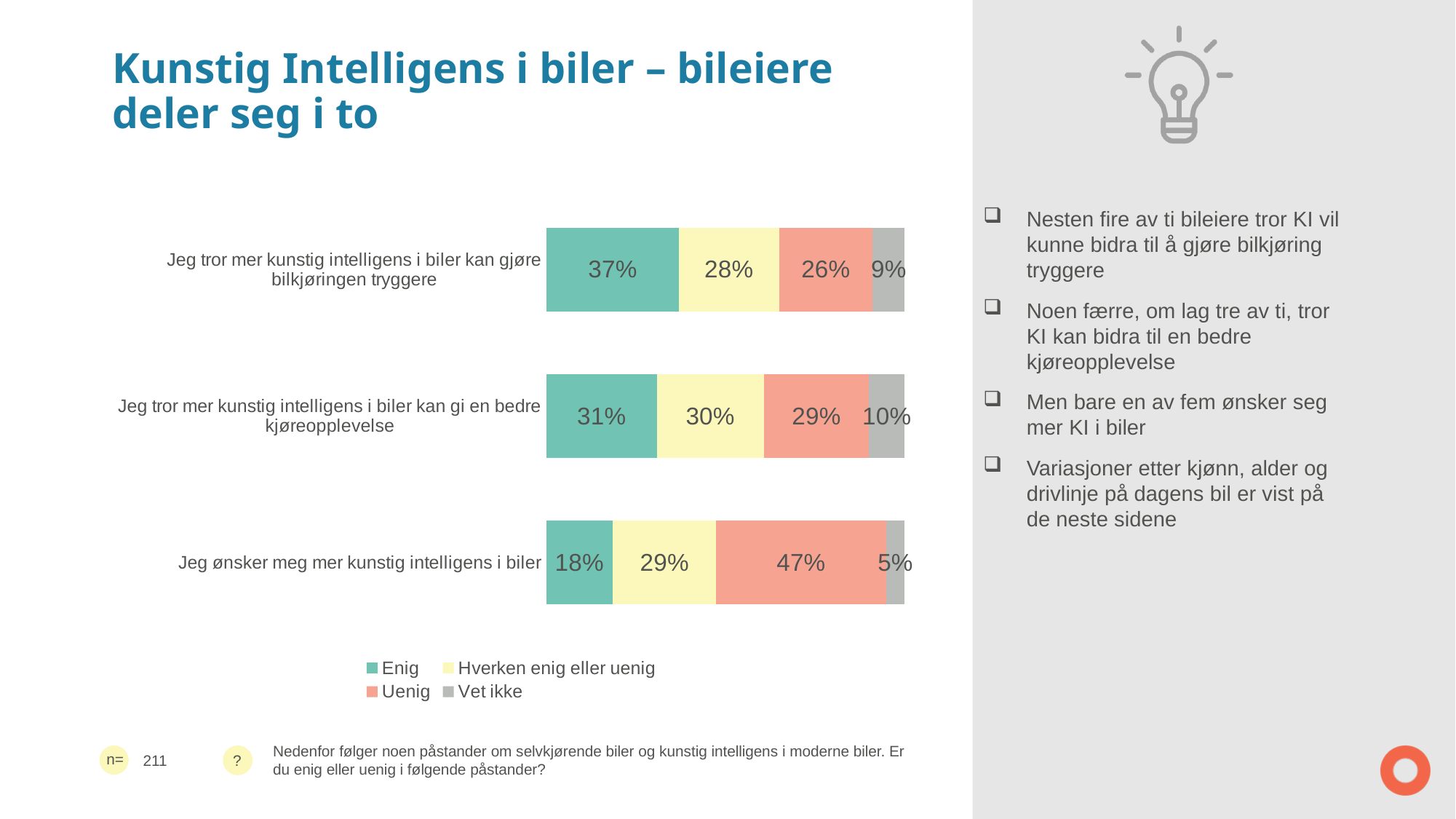
What is the "Uenig" value for the statement "Jeg ønsker meg mer kunstig intelligens i biler"? 47% What is the combined share of "Enig" and "Hverken enig eller uenig" for the statement "Jeg ønsker meg mer kunstig intelligens i biler"? 47% What is the difference between the "Uenig" share for "Jeg ønsker meg mer kunstig intelligens i biler" and the "Uenig" share for "Jeg tror mer kunstig intelligens i biler kan gjøre bilkjøringen tryggere"? 21 percentage points What percentage of respondents agree (Enig) with the statement "Jeg tror mer kunstig intelligens i biler kan gjøre bilkjøringen tryggere"? 37% How many series does the legend list? 4 Which colour represents "Uenig" in the chart? Red/salmon Which statement has the lowest "Vet ikke" share? Jeg ønsker meg mer kunstig intelligens i biler How many statements (bars) are shown in the chart? 3 Which statement has the highest "Enig" share? Jeg tror mer kunstig intelligens i biler kan gjøre bilkjøringen tryggere For the statement "Jeg tror mer kunstig intelligens i biler kan gi en bedre kjøreopplevelse", which is larger: the "Enig" share or the "Uenig" share? Enig What kind of chart is shown on the slide? Stacked bar chart What is the "Vet ikke" value for the statement "Jeg tror mer kunstig intelligens i biler kan gi en bedre kjøreopplevelse"? 10%